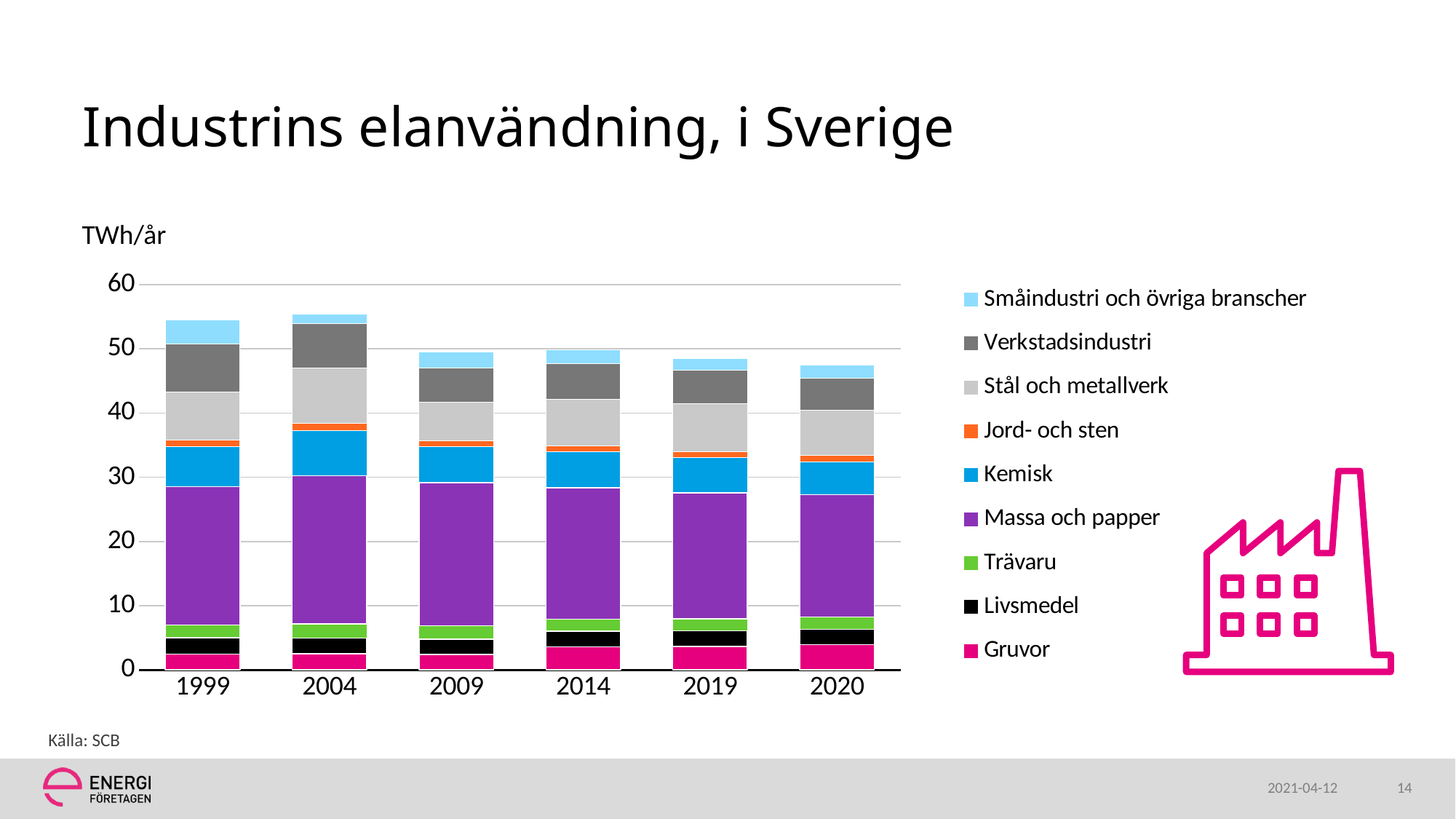
Is the total bar height for 2004 greater or less than 50? greater How many series does the chart's legend list? 9 What unit is shown above the y axis of the chart? TWh/år What kind of chart is shown on the slide? Stacked bar chart How many years are shown on the x axis of the chart? 6 Which year has the larger total bar, 2004 or 2019? 2004 Is the total bar height for 1999 greater or less than 50? greater Which year has the larger total bar, 1999 or 2020? 1999 What is the title of the chart on the slide? Industrins elanvändning, i Sverige Do the total bar heights generally rise or fall from 1999 to 2020? fall Which series forms the largest segment of the 2020 bar? Massa och papper Is the total bar height for 2020 greater or less than 50? less